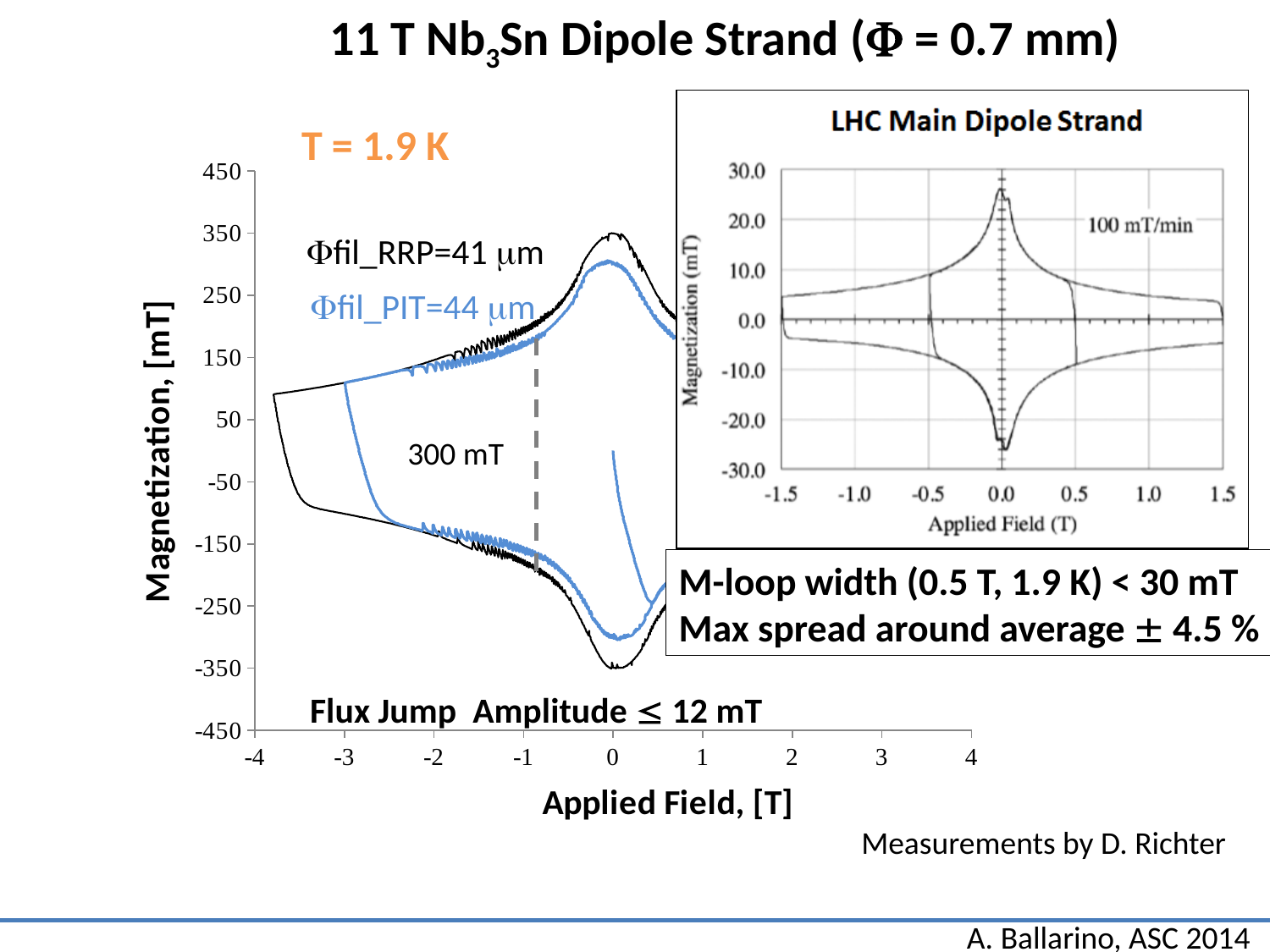
What kind of chart is the main chart on the left (11 T Nb3Sn Dipole Strand)? line chart What is the title of the inset chart on the right? LHC Main Dipole Strand In the main chart on the left, what is the filament diameter given for the PIT strand? 44 μm In the main chart on the left, how many strand curves are plotted? 2 In the inset chart (LHC Main Dipole Strand), is the peak magnetization near 0 T greater or less than 20.0 mT? greater In the main chart on the left, is the minimum magnetization of the blue PIT curve greater or less than -250 mT? less At what temperature were the measurements in the main chart on the left taken? T = 1.9 K In the inset chart (LHC Main Dipole Strand), what field ramp rate is annotated on the plot? 100 mT/min In the main chart on the left, which curve reaches the higher peak magnetization near 0 T, the black RRP curve or the blue PIT curve? black RRP curve In the main chart on the left, is the peak magnetization of the black RRP curve near 0 T greater or less than 250 mT? greater In the main chart on the left, what is the filament diameter given for the RRP strand? 41 μm In the main chart on the left, what is the maximum value shown on the Magnetization axis? 450